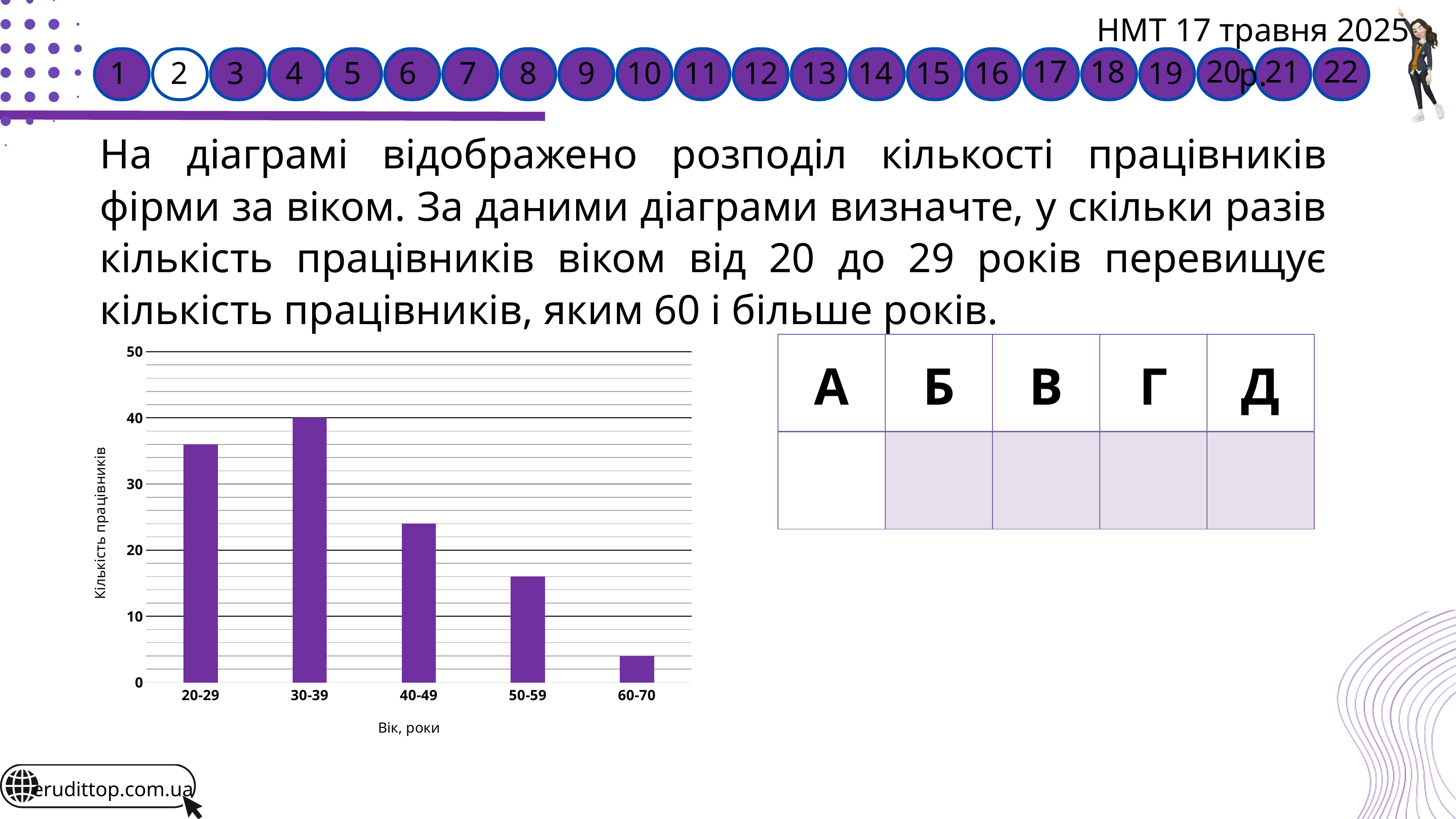
How many age categories are shown on the x axis of the chart? 5 Which age group has the highest number of employees? 30-39 Is the value for the 40-49 age group greater or less than 20? greater Is the value for the 60-70 age group greater or less than 10? less Do the values rise or fall from the 30-39 group to the 60-70 group along the x axis? fall Which age group has the lowest number of employees? 60-70 What is the label of the vertical axis of the chart? Кількість працівників Is the value for the 20-29 age group greater or less than 30? greater What is the number of employees in the 30-39 age group? 40 Which age group has more employees, 20-29 or 40-49? 20-29 What kind of chart is shown on the slide? bar chart